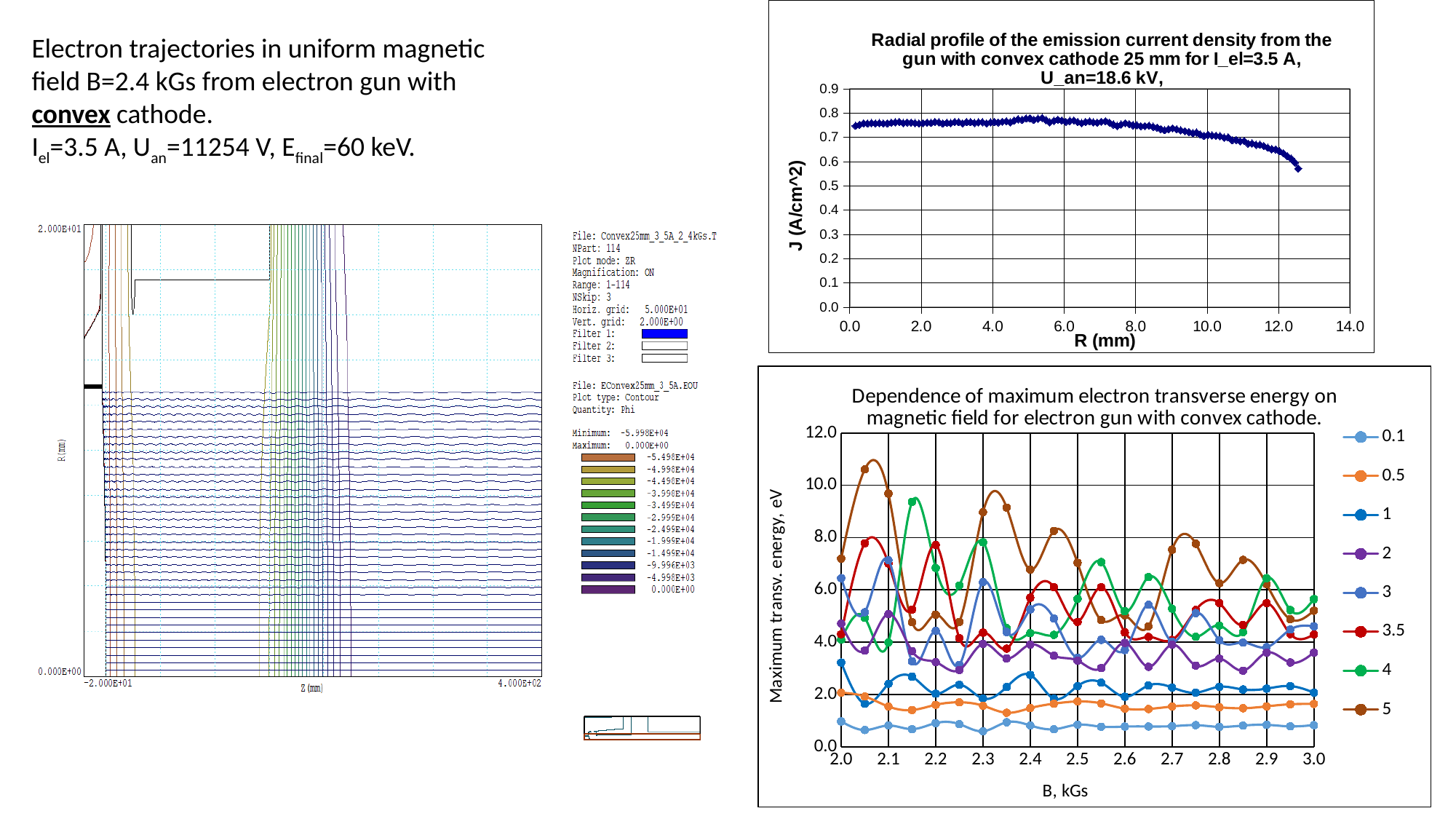
In the chart titled 'Dependence of maximum electron transverse energy on magnetic field', which series has the lowest values across the whole range of B? 0.1 In the chart titled 'Dependence of maximum electron transverse energy on magnetic field', what is the label of the x axis? B, kGs In the chart titled 'Dependence of maximum electron transverse energy on magnetic field', is the value of series 5 at B=2.05 greater or less than 10.0? greater What kind of chart is the chart titled 'Dependence of maximum electron transverse energy on magnetic field for electron gun with convex cathode'? line chart How many series does the legend of the chart titled 'Dependence of maximum electron transverse energy on magnetic field for electron gun with convex cathode' list? 8 In the chart titled 'Radial profile of the emission current density from the gun with convex cathode 25 mm', do the values rise or fall as R increases from 8.0 mm to 12.0 mm? fall In the chart titled 'Dependence of maximum electron transverse energy on magnetic field', at B=2.0, which series has the larger value: series 5 or series 0.5? 5 In the chart titled 'Radial profile of the emission current density from the gun with convex cathode 25 mm', is the value of J at R=12.0 mm greater or less than 0.7? less In the chart titled 'Dependence of maximum electron transverse energy on magnetic field', which series reaches the highest value on the chart? 5 In the chart titled 'Radial profile of the emission current density from the gun with convex cathode 25 mm', is the value of J at R=0.0 mm greater or less than 0.7? greater In the chart titled 'Radial profile of the emission current density from the gun with convex cathode 25 mm', what is the label of the y axis? J (A/cm^2)